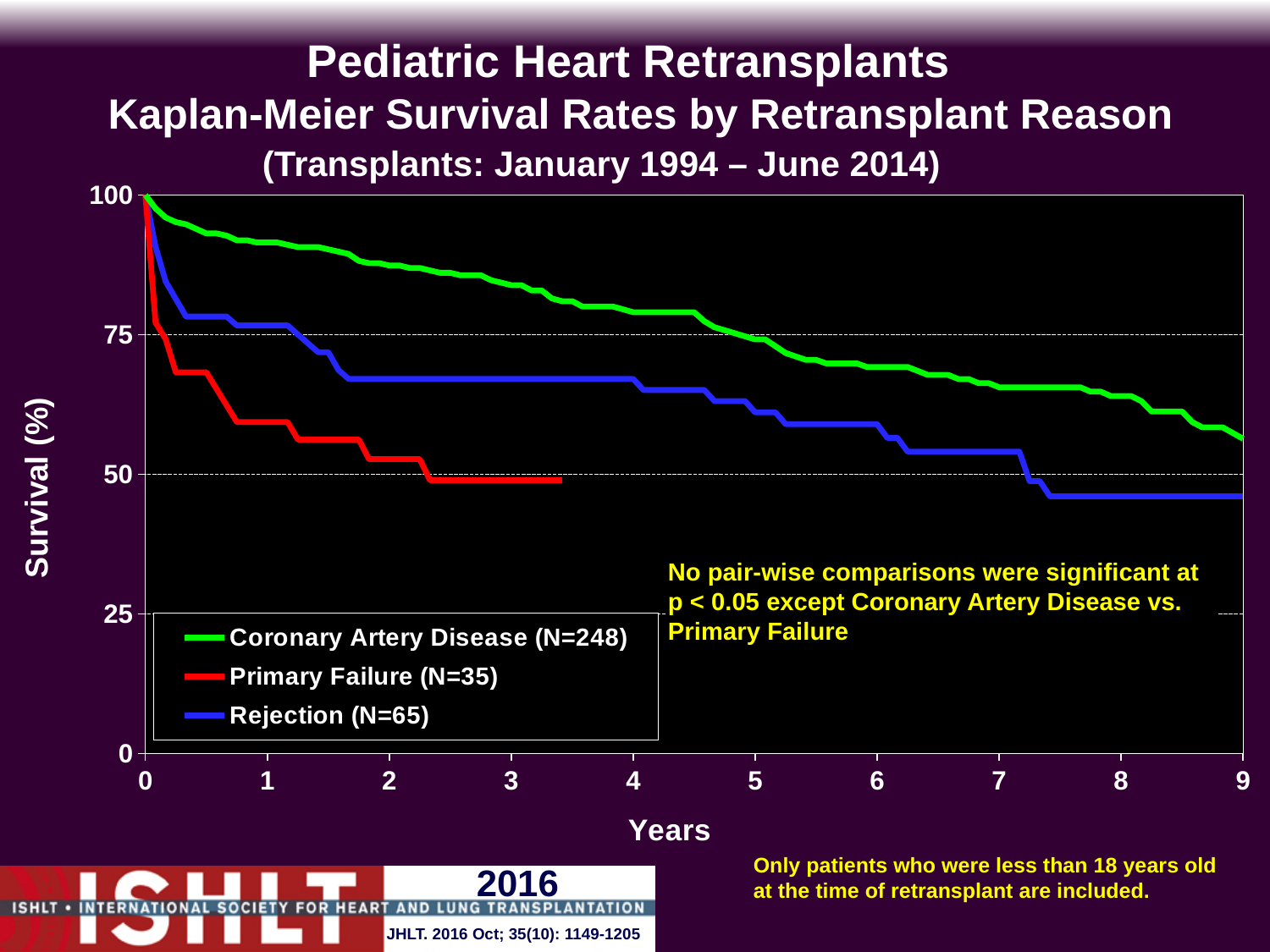
What is the N for the Rejection group in the legend? 65 Is the survival for Rejection at 9 years greater or less than 50%? less Is the survival for Coronary Artery Disease at 9 years greater or less than 50%? greater How many series does the legend list? 3 Which group has the lowest survival at 2 years? Primary Failure Is the survival for Rejection at 2 years greater or less than 75%? less Do the survival curves rise or fall as years increase? fall What kind of chart is shown on the slide? Line chart At 5 years, which group has higher survival: Coronary Artery Disease or Rejection? Coronary Artery Disease What is the N for the Coronary Artery Disease group in the legend? 248 What is the N for the Primary Failure group in the legend? 35